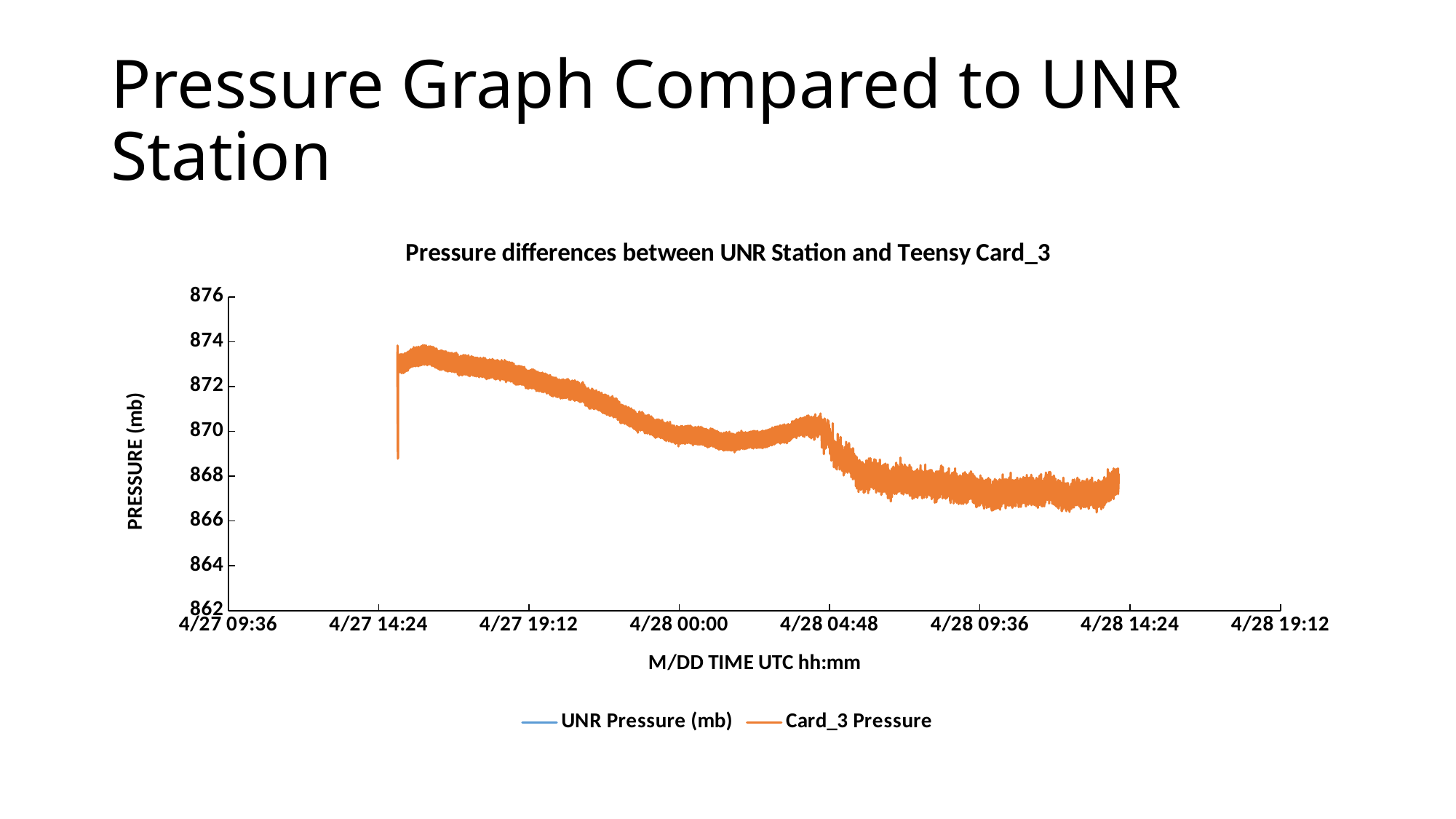
Is the Card_3 Pressure at 4/28 09:36 greater or less than 870? less What kind of chart is shown on the slide? line chart Does the Card_3 Pressure overall rise or fall from left to right across the plotted period? fall Is the Card_3 Pressure at 4/27 19:12 greater or less than 870? greater Does the Card_3 Pressure reach its highest value near the start or near the end of the plotted period? near the start How many series does the legend list? 2 What is the title of the chart? Pressure differences between UNR Station and Teensy Card_3 Is the Card_3 Pressure higher at 4/27 19:12 or at 4/28 09:36? 4/27 19:12 Is the Card_3 Pressure at 4/28 00:00 greater or less than 868? greater What is the label of the y axis? PRESSURE (mb)